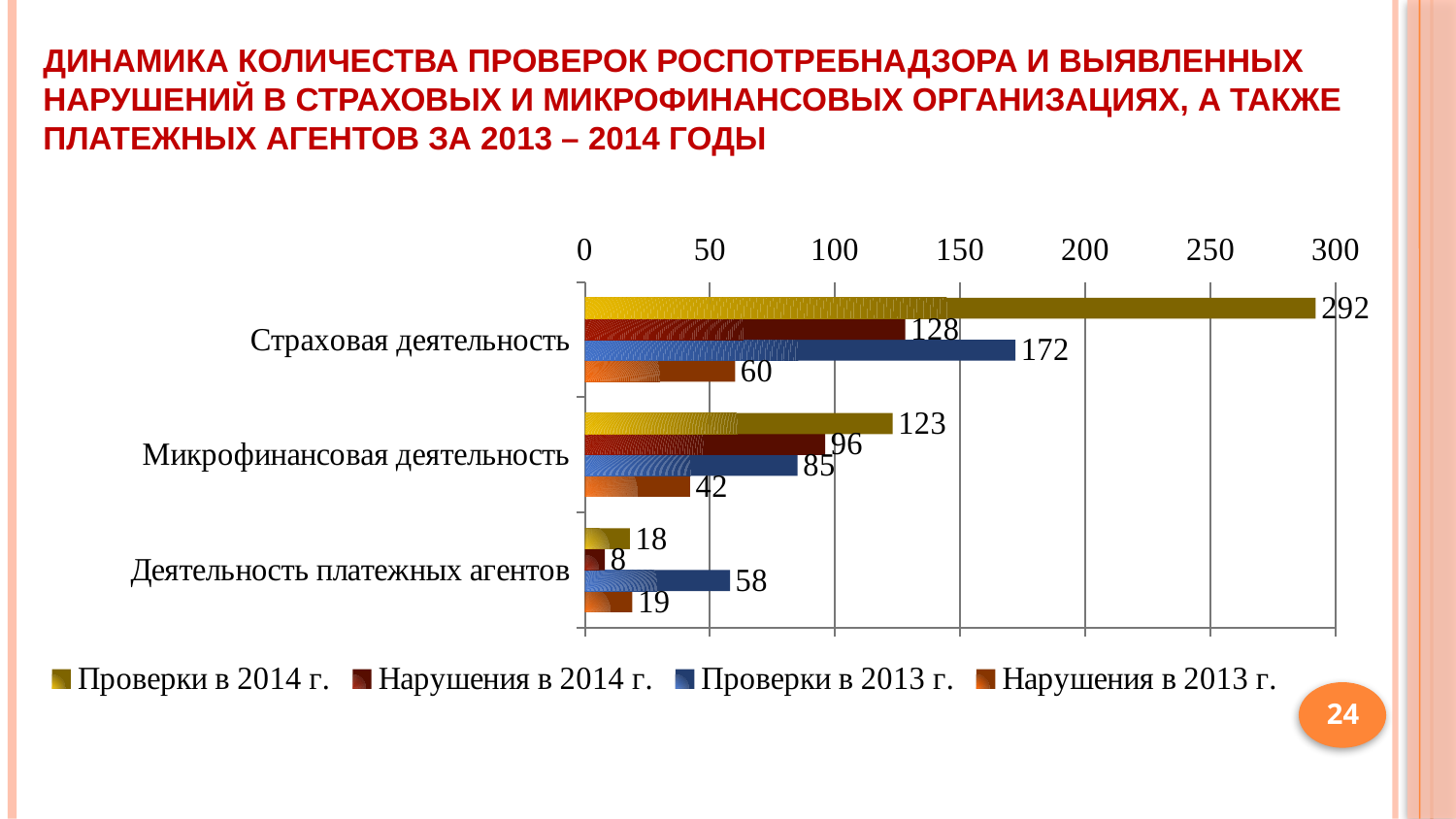
What is the value of Нарушения в 2013 г. for Микрофинансовая деятельность? 42 Which category has the lowest value for Нарушения в 2014 г.? Деятельность платежных агентов What is the value of Проверки в 2014 г. for Страховая деятельность? 292 What is the value of Проверки в 2013 г. for Деятельность платежных агентов? 58 How many categories are shown on the chart? 3 Is the value of Нарушения в 2014 г. for Микрофинансовая деятельность greater or less than 100? less What is the difference between Нарушения в 2014 г. and Нарушения в 2013 г. for Микрофинансовая деятельность? 54 What kind of chart is shown on the slide? bar chart How many series does the legend list? 4 What is the difference between Проверки в 2014 г. and Проверки в 2013 г. for Страховая деятельность? 120 For Деятельность платежных агентов, which is larger: Проверки в 2013 г. or Проверки в 2014 г.? Проверки в 2013 г. Which category has the highest value for Проверки в 2014 г.? Страховая деятельность